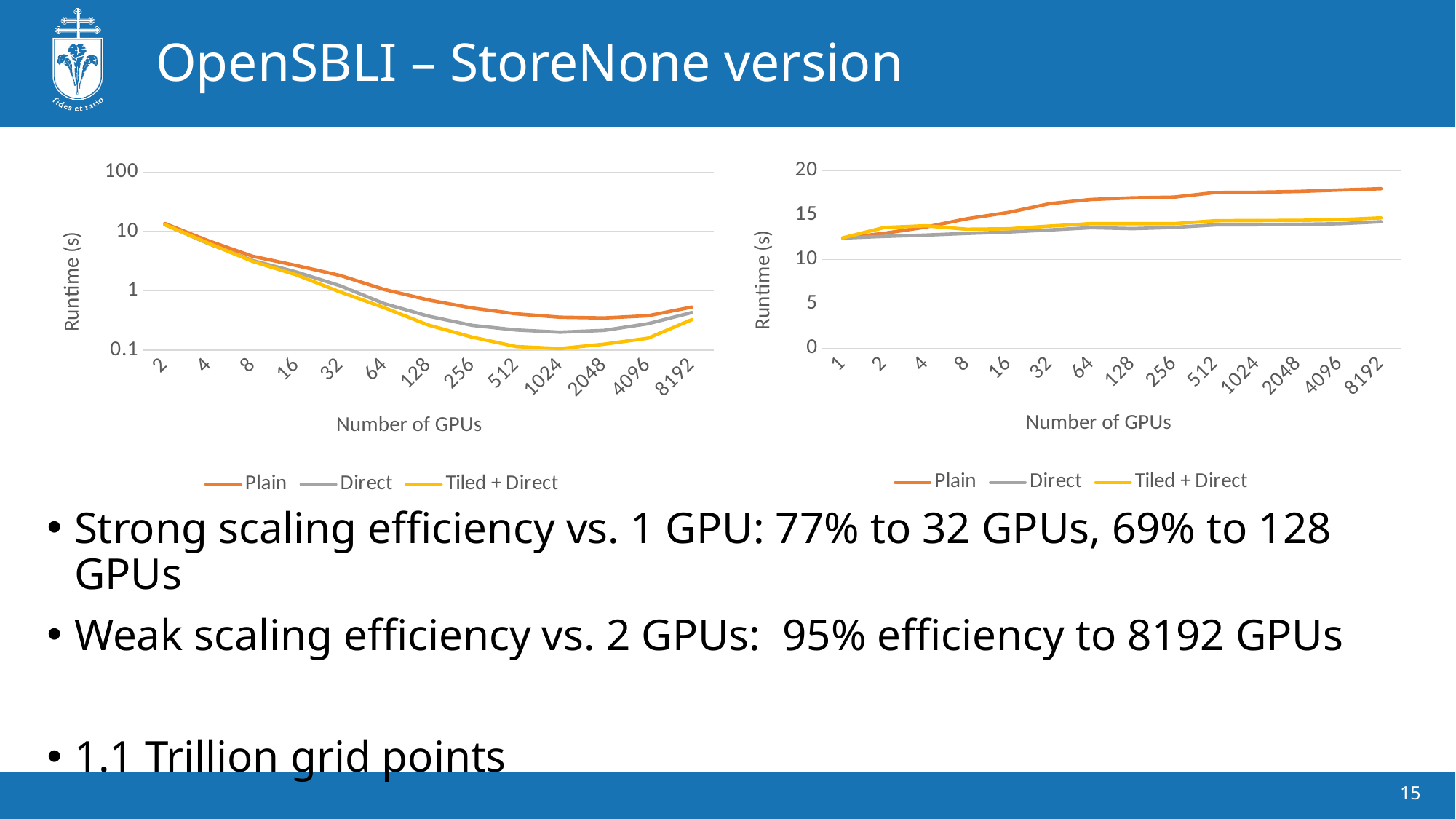
How many GPU counts are shown on the x axis of the left chart? 13 How many GPU counts are shown on the x axis of the right chart? 14 What kind of chart is the right chart? line chart In the right chart, is the runtime for Direct at 1 GPU greater or less than 15? less In the right chart, is the runtime for Plain at 8192 GPUs greater or less than 15? greater How many series does the legend of the left chart list? 3 In the left chart, is the runtime for Plain at 1024 GPUs greater or less than 1? less What kind of chart is the left chart? line chart In the right chart, does the Plain runtime generally rise or fall as the number of GPUs increases? rise In the left chart, which series has the larger runtime at 128 GPUs, Plain or Tiled + Direct? Plain In the right chart, which series has the highest runtime at 8192 GPUs? Plain In the left chart, which series has the lowest runtime at 1024 GPUs? Tiled + Direct